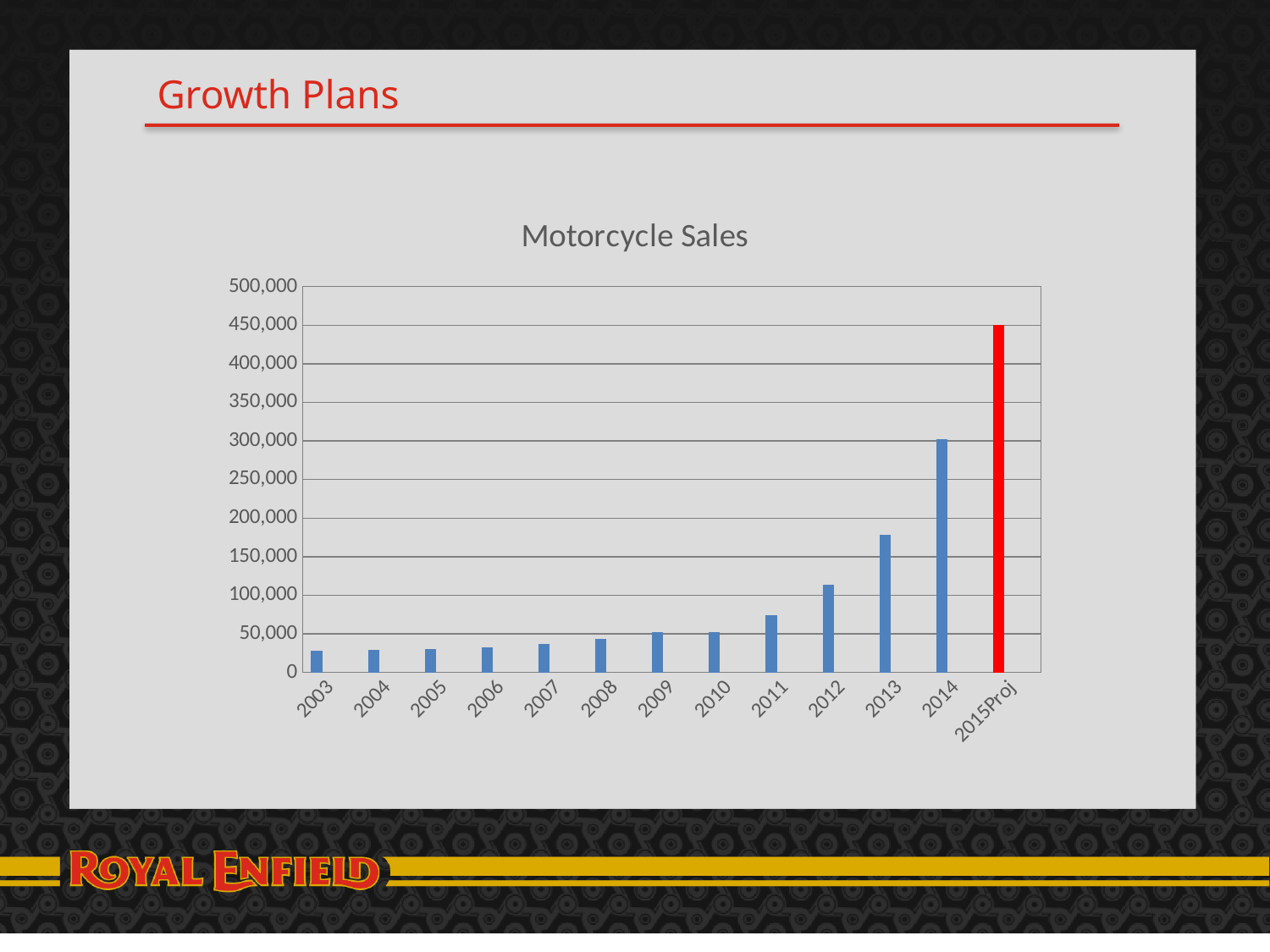
What is the value for 2015Proj? 450,000 Is the value for 2008 greater or less than 50,000? less How many years (categories) are plotted on the x axis? 13 Is the value for 2012 greater or less than 100,000? greater Do motorcycle sales generally rise or fall from 2003 to 2015Proj? Rise Is the value for 2011 greater or less than 100,000? less Which is larger, the value for 2013 or the value for 2012? 2013 Which category has the highest motorcycle sales? 2015Proj What is the title of the chart? Motorcycle Sales What kind of chart is shown on the slide? Bar chart